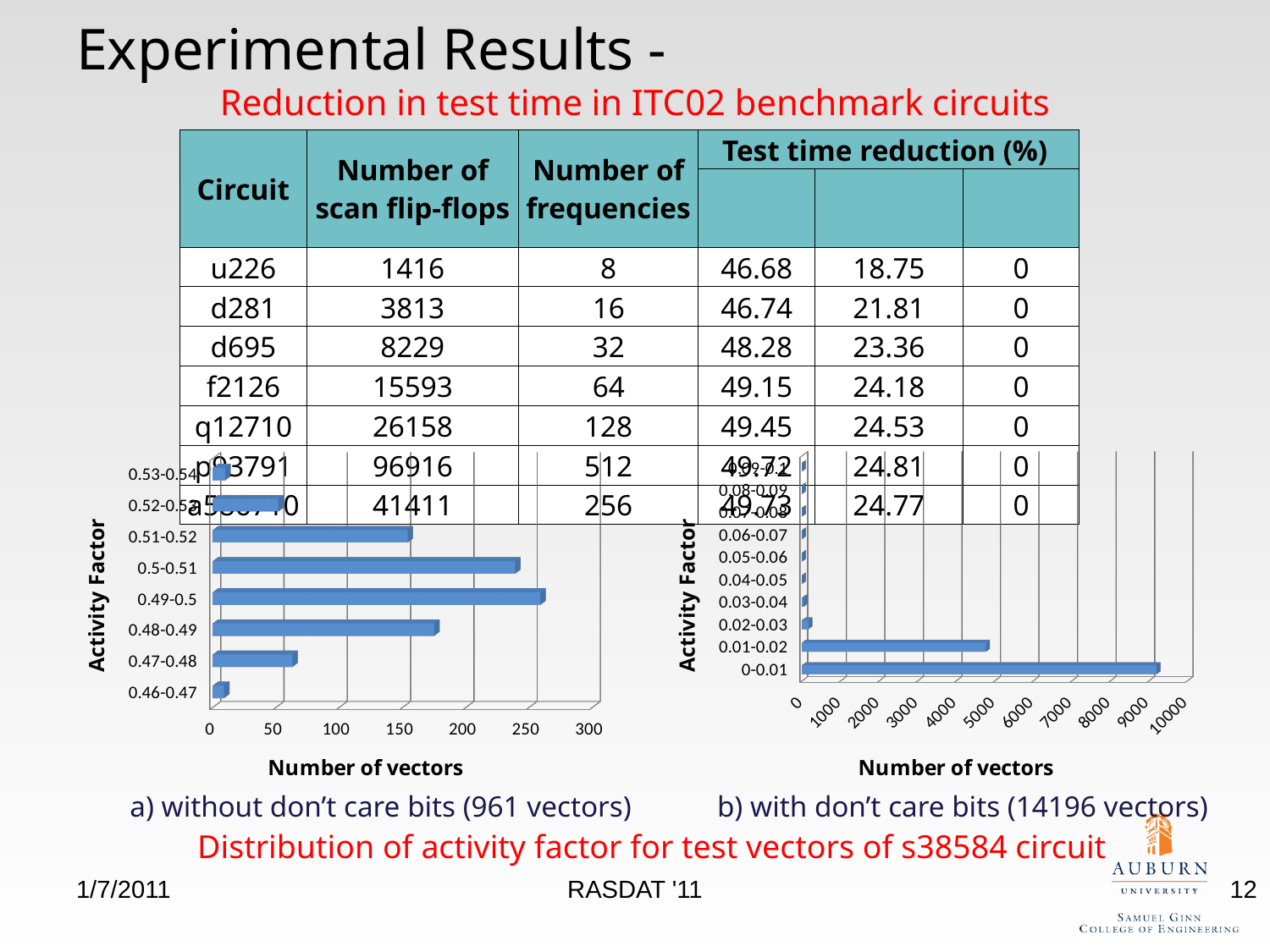
In chart b) with don't care bits, is the number of vectors for 0-0.01 greater or less than 8000? greater In chart b) with don't care bits, is the number of vectors for 0.02-0.03 greater or less than 1000? less What kind of chart is chart a) without don't care bits? bar chart In chart b) with don't care bits, is the number of vectors for 0.01-0.02 greater or less than 4000? greater In chart a) without don't care bits, which activity factor range has the highest number of vectors? 0.49-0.5 In chart b) with don't care bits, which activity factor range has the highest number of vectors? 0-0.01 In chart a) without don't care bits, which has more vectors: 0.48-0.49 or 0.47-0.48? 0.48-0.49 What is the x-axis title of chart b) with don't care bits? Number of vectors